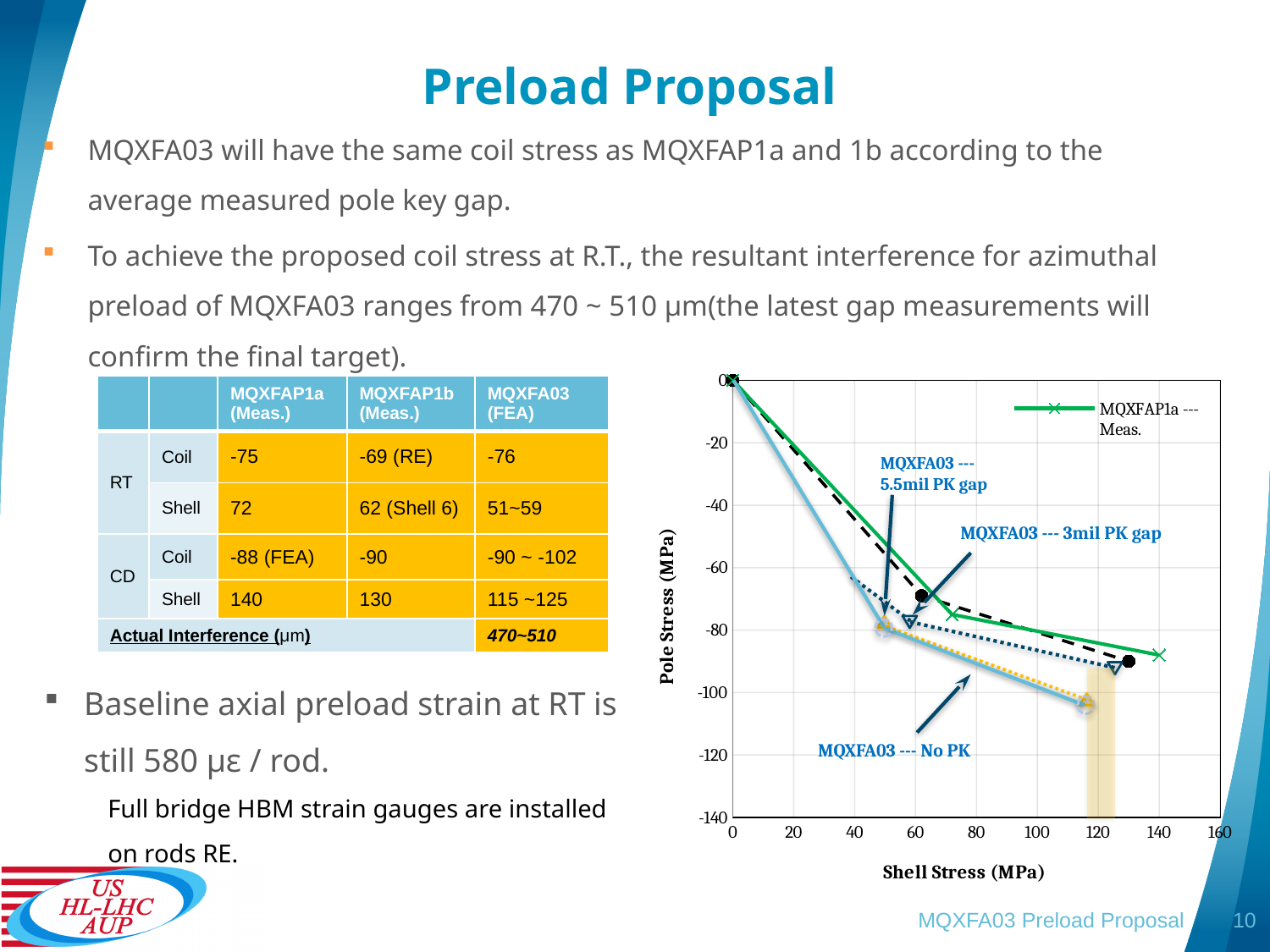
What is the title of the y axis of the chart? Pole Stress (MPa) As shell stress increases along the x axis, does the pole stress rise or fall? fall Which line reaches a higher shell stress at its end point, MQXFAP1a --- Meas. or MQXFA03 --- No PK? MQXFAP1a --- Meas. How many series does the chart's legend list? 1 Is the pole stress at the end point of the MQXFA03 --- No PK line above or below -80 on the y axis? below Is the shell stress at the final point of the MQXFAP1a --- Meas. line greater or less than 120? greater What is the title of the x axis of the chart? Shell Stress (MPa) What is the pole stress at the starting point shared by all the lines in the chart? 0 Is the shell stress at the final point of the MQXFA03 --- No PK line greater or less than 100? greater Which labelled line reaches the lowest (most negative) pole stress in the chart? MQXFA03 --- No PK What kind of chart is shown on the slide? line chart